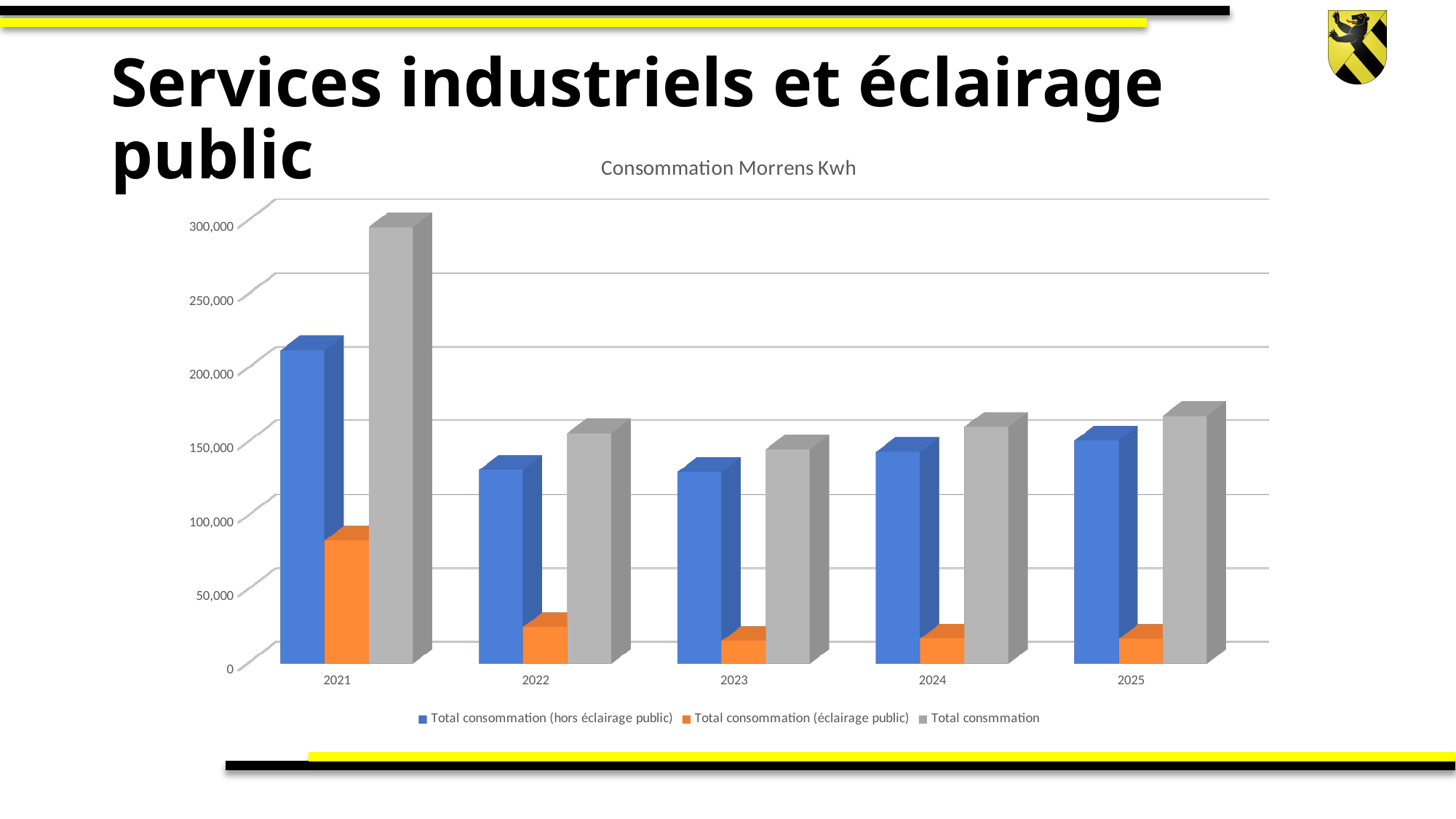
What kind of chart is shown on the slide? bar chart How many series does the chart legend list? 3 Is the value for Total consommation (éclairage public) in 2021 greater or less than 100,000? less What is the title of the chart? Consommation Morrens Kwh Which year has the highest value for Total consommation (hors éclairage public)? 2021 Is the value for Total consmmation in 2025 greater or less than 150,000? greater Which is larger: Total consommation (hors éclairage public) in 2021 or in 2025? 2021 Which year has the highest value for Total consmmation? 2021 How many years are shown on the x axis of the chart? 5 Which colour represents Total consommation (éclairage public) in the chart? orange Is the value for Total consommation (éclairage public) in 2022 greater or less than 50,000? less